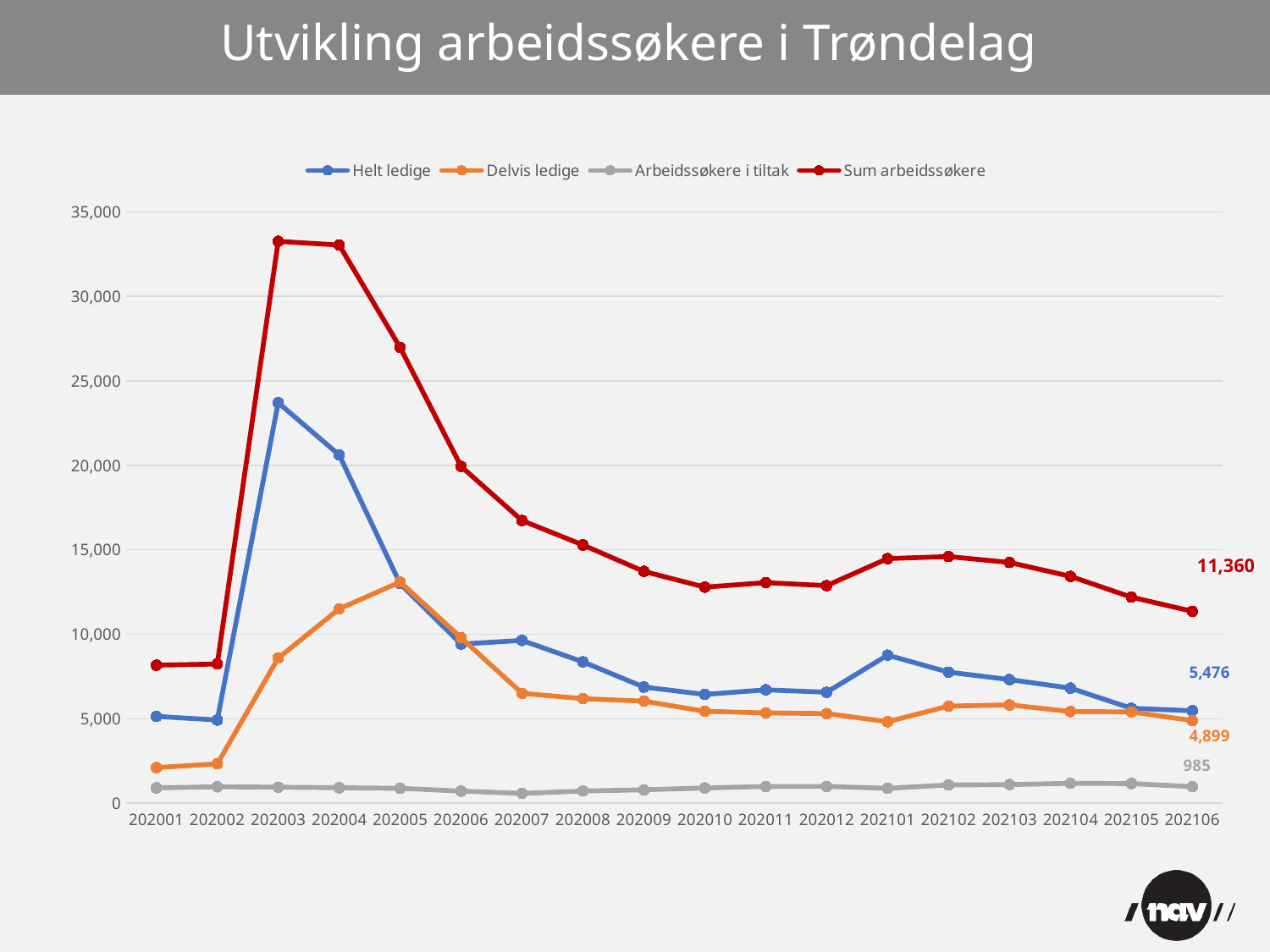
How many periods are shown along the x axis? 18 What is the value of Helt ledige at 202106? 5,476 What is the value of Sum arbeidssøkere at 202106? 11,360 How many series does the legend list? 4 Is the value for Sum arbeidssøkere at 202003 greater or less than 30,000? greater What is the difference between Helt ledige and Delvis ledige at 202106? 577 In which period does Helt ledige reach its highest value? 202003 Which series has the lowest value at 202106? Arbeidssøkere i tiltak What kind of chart is shown on the slide? Line chart What is the value of Delvis ledige at 202106? 4,899 What is the value of Arbeidssøkere i tiltak at 202106? 985 Does Sum arbeidssøkere rise or fall from 202102 to 202106? Fall